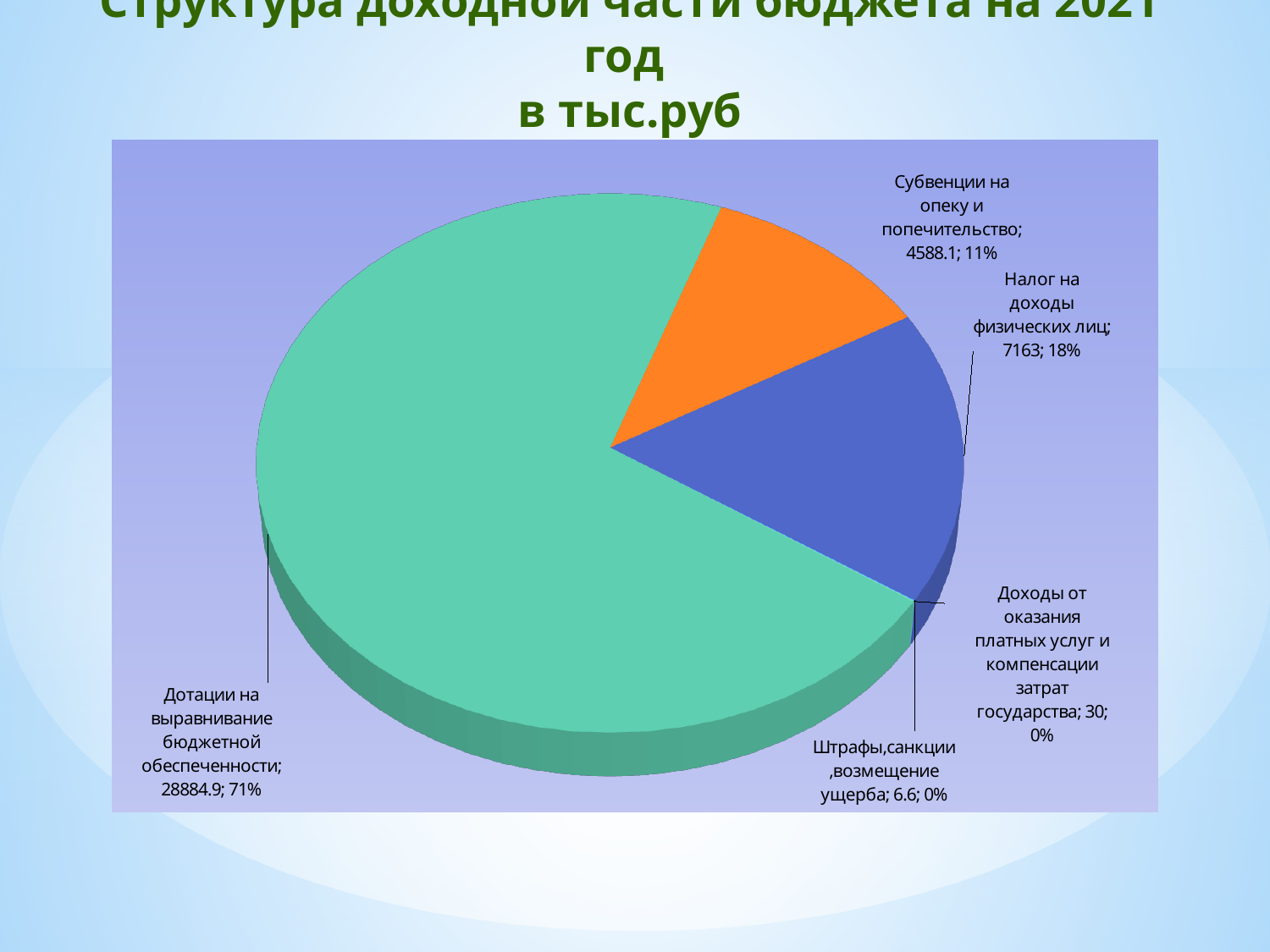
Which is larger: the value for Доходы от оказания платных услуг и компенсации затрат государства or the value for Штрафы,санкции,возмещение ущерба? Доходы от оказания платных услуг и компенсации затрат государства Which category has the largest slice? Дотации на выравнивание бюджетной обеспеченности What type of chart is shown on the slide? Pie chart What is the value for Штрафы,санкции,возмещение ущерба? 6.6 What is the value for Налог на доходы физических лиц? 7163 What share of the pie does Налог на доходы физических лиц represent? 18% What is the difference between the values for Налог на доходы физических лиц and Субвенции на опеку и попечительство? 2574.9 Which category has the smallest value? Штрафы,санкции,возмещение ущерба How many slices does the pie chart have? 5 What share of the pie does Дотации на выравнивание бюджетной обеспеченности represent? 71% What is the value for Субвенции на опеку и попечительство? 4588.1 What is the value for Дотации на выравнивание бюджетной обеспеченности? 28884.9